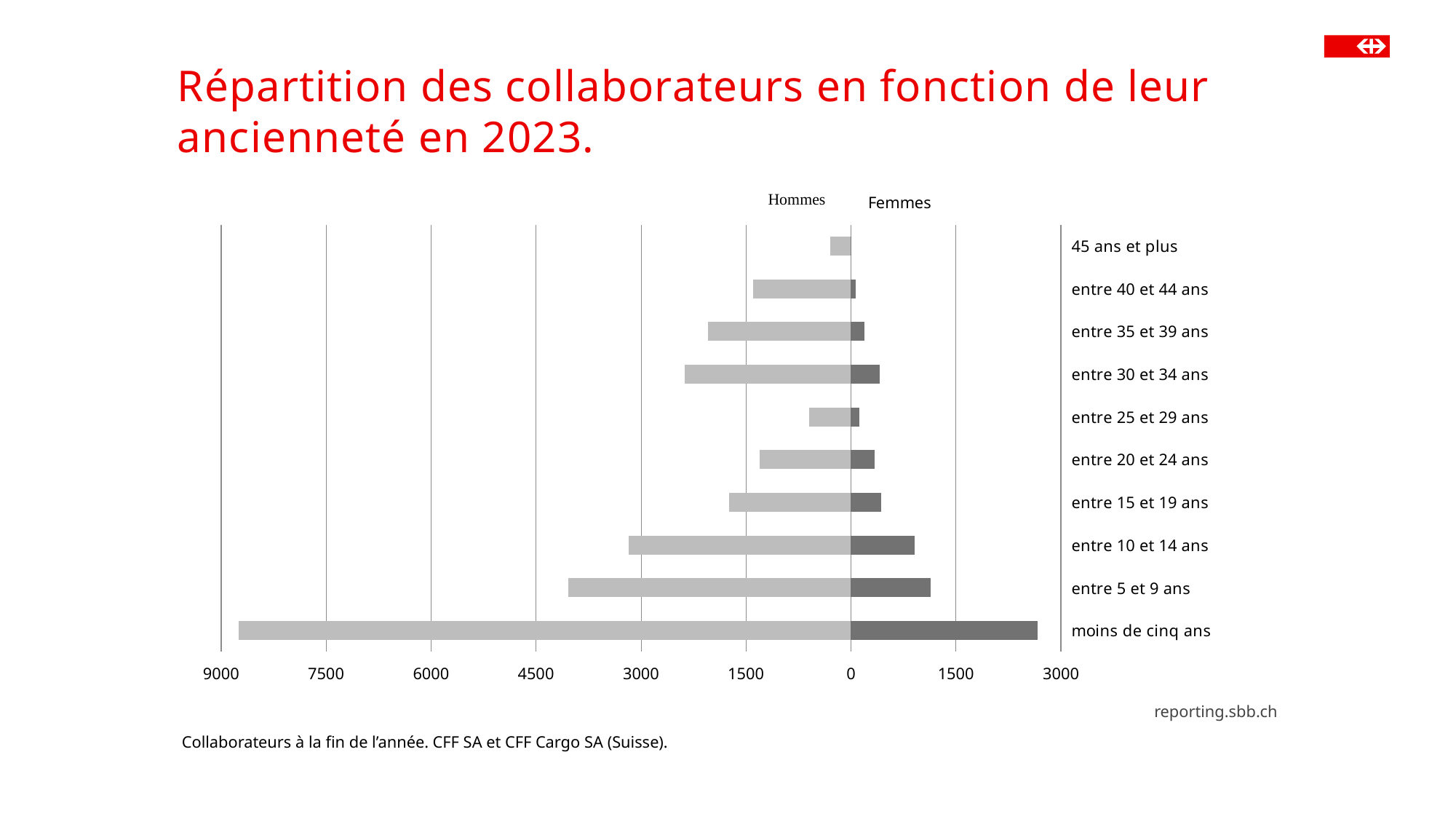
How many seniority categories are shown on the chart? 10 Which is larger for Hommes: 'entre 5 et 9 ans' or 'entre 10 et 14 ans'? entre 5 et 9 ans Is the Hommes value for 'moins de cinq ans' greater or less than 7500? greater Is the Femmes value for 'moins de cinq ans' greater or less than 1500? greater What kind of chart is shown on the slide? bar chart Which seniority category has the lowest value for Hommes? 45 ans et plus Is the Hommes value for 'entre 5 et 9 ans' greater or less than 3000? greater How many series does the chart show? 2 Which series is plotted on the left side of the chart? Hommes Which seniority category has the highest value for Hommes? moins de cinq ans Which seniority category has the highest value for Femmes? moins de cinq ans